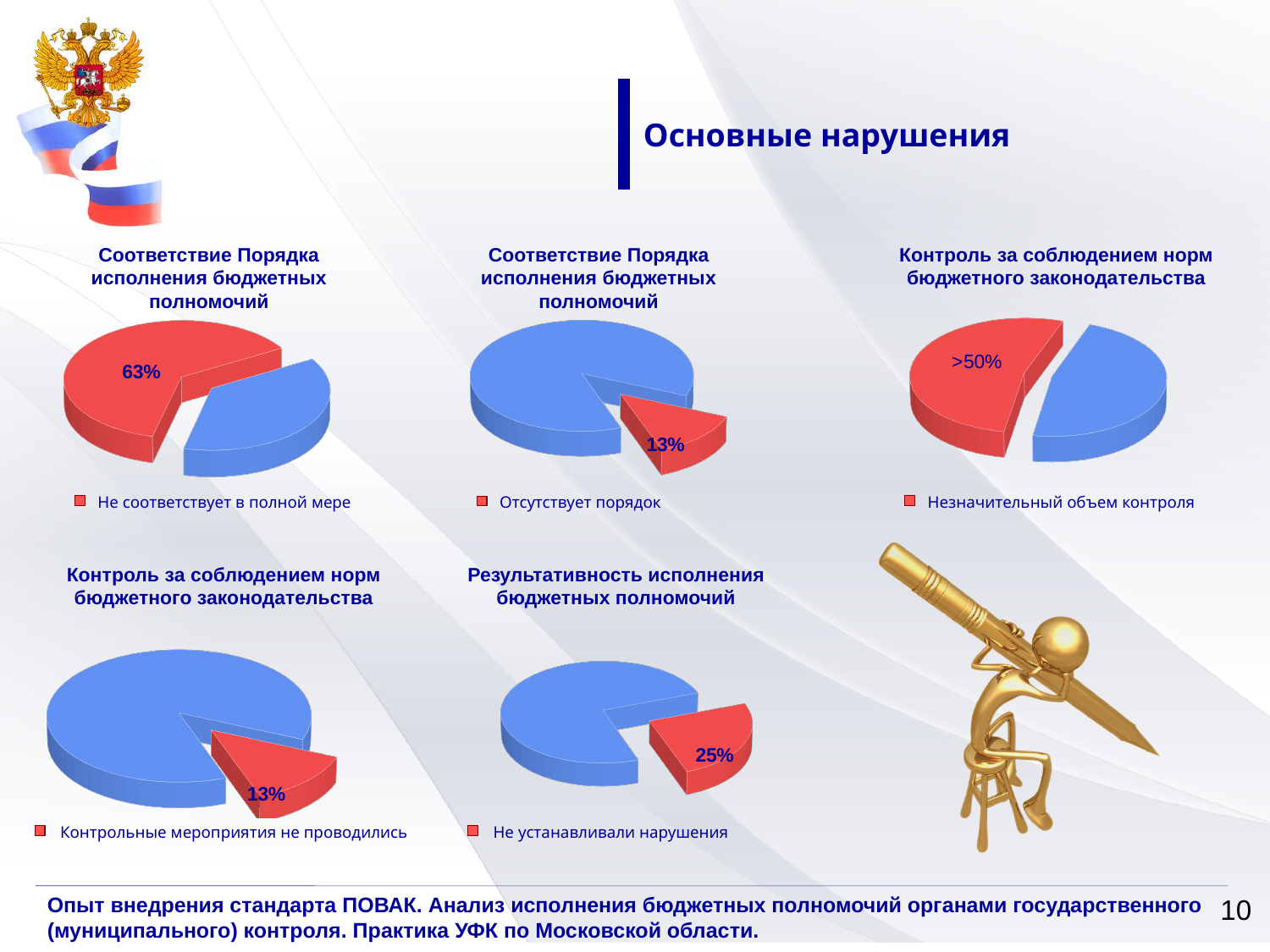
In the bottom-left pie chart, which slice is larger, the red slice or the blue slice? The blue slice What is the title of the bottom-middle pie chart? Результативность исполнения бюджетных полномочий In the top-middle pie chart, what percentage is shown for the red slice 'Отсутствует порядок'? 13% What kind of chart is the top-left chart titled 'Соответствие Порядка исполнения бюджетных полномочий'? Pie chart In the bottom-middle pie chart, which slice is smaller, the red slice or the blue slice? The red slice In the top-left pie chart, what percentage is shown for the red slice 'Не соответствует в полной мере'? 63% In the top-left pie chart, which slice is larger, the red slice or the blue slice? The red slice In the bottom-left pie chart, what percentage is shown for the red slice 'Контрольные мероприятия не проводились'? 13% What is the legend entry shown under the top-right pie chart? Незначительный объем контроля In the top-right pie chart titled 'Контроль за соблюдением норм бюджетного законодательства', what value is printed on the red slice? >50% How many pie charts are shown on the slide? 5 In the bottom-middle pie chart titled 'Результативность исполнения бюджетных полномочий', what percentage is shown for the red slice 'Не устанавливали нарушения'? 25%